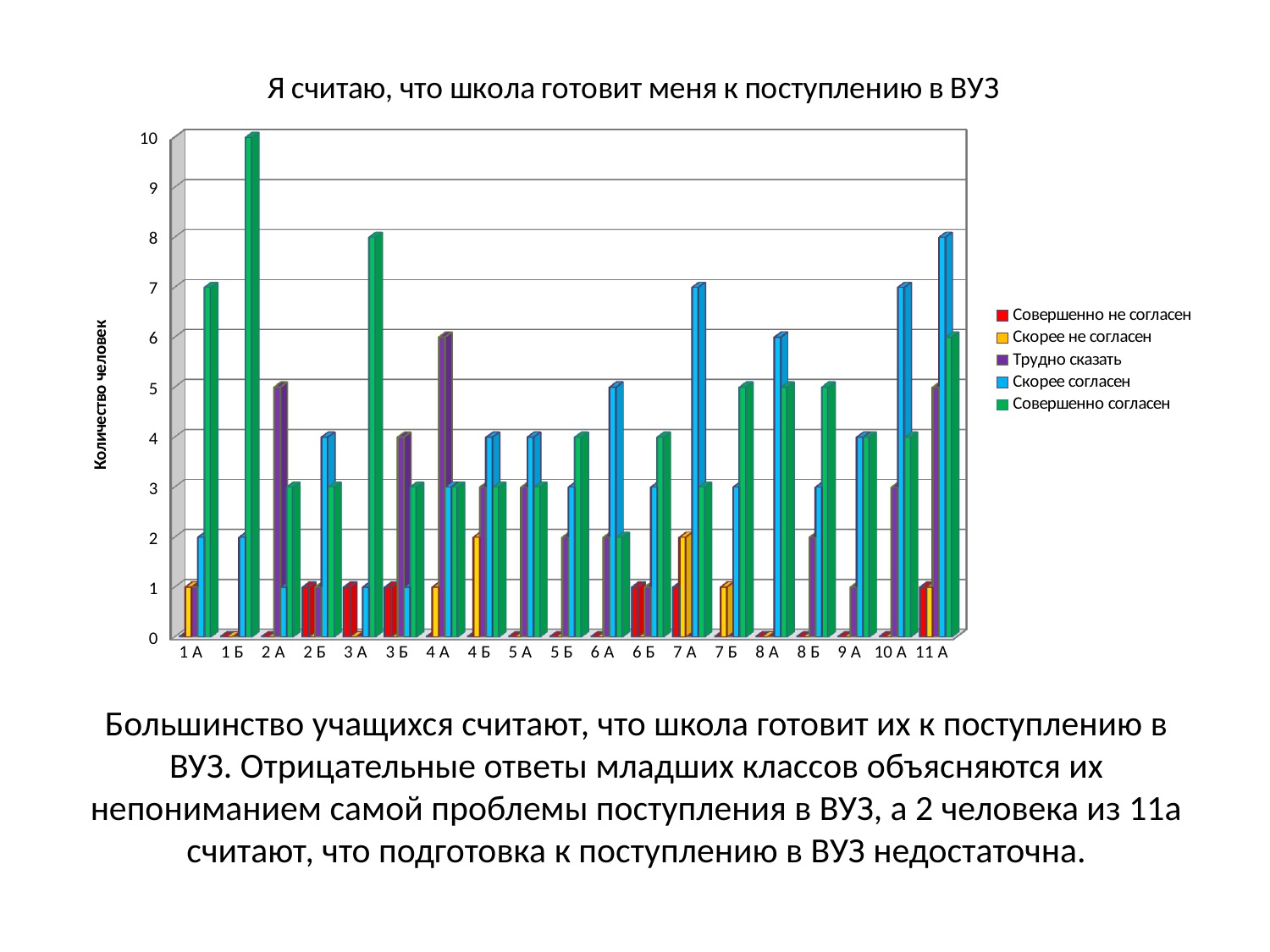
Which class has the highest value for "Скорее согласен"? 11 А What is the value for "Совершенно согласен" for class 3 А? 8 What kind of chart is shown on the slide? bar chart Is the value for "Скорее согласен" for class 11 А greater or less than 6? greater Which class has the highest value for "Совершенно согласен"? 1 Б Which is larger for class 7 А: "Скорее согласен" or "Совершенно согласен"? Скорее согласен What is the label of the vertical axis? Количество человек How many series does the legend list? 5 What is the value for "Совершенно согласен" for class 1 Б? 10 What is the title of the chart? Я считаю, что школа готовит меня к поступлению в ВУЗ How many class categories are shown on the x axis? 19 Is the value for "Трудно сказать" for class 4 А greater or less than 4? greater